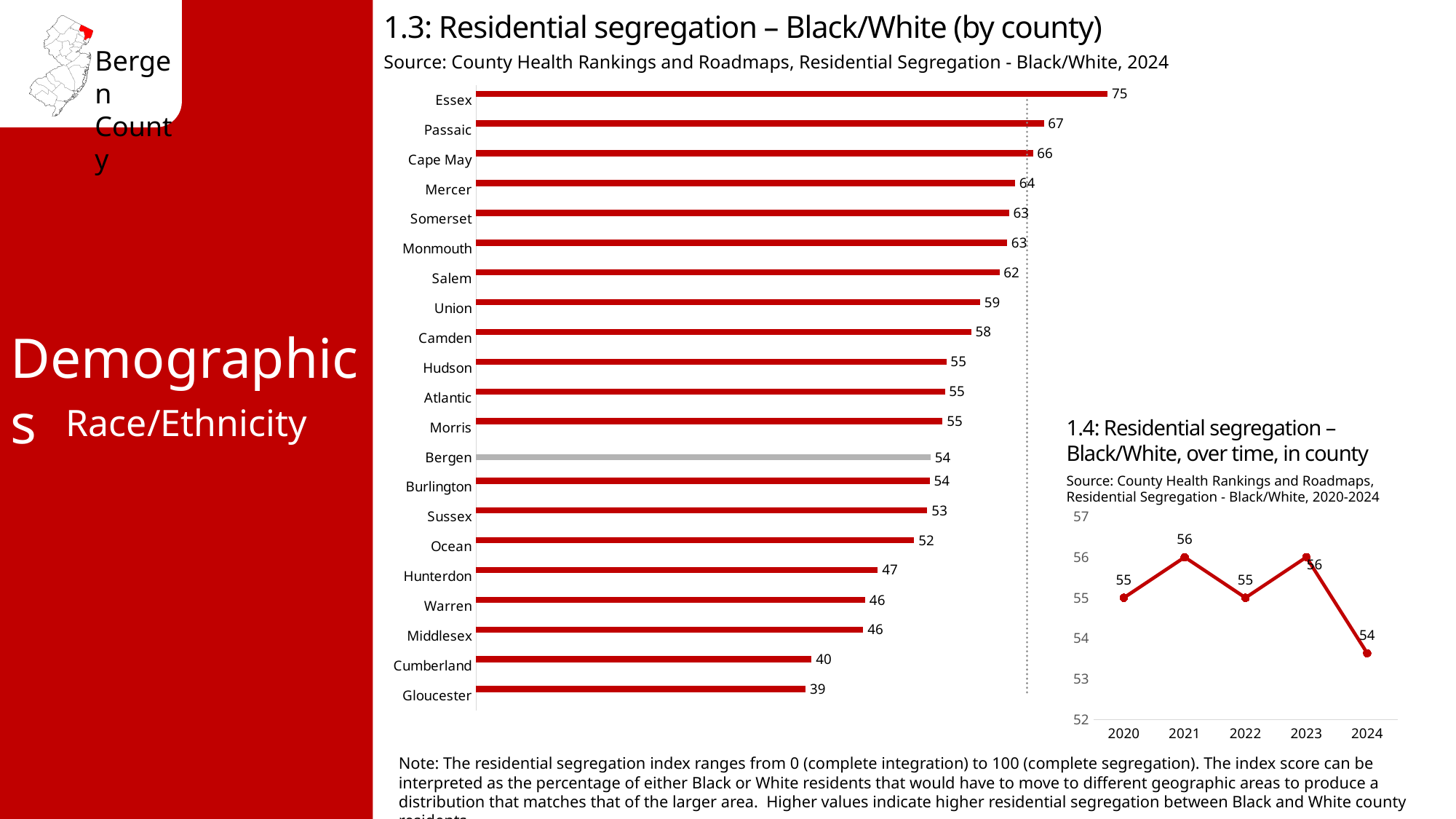
In chart 1.3 (Residential segregation – Black/White by county), what is the value for Bergen? 54 In chart 1.3 (by county), what is the value for Essex? 75 In chart 1.3 (by county), which county has the highest value? Essex In chart 1.4 (over time), what is the difference between the values for 2023 and 2024? 2 In chart 1.3 (by county), how many counties are shown? 21 In chart 1.4 (Residential segregation over time), what is the value for 2024? 54 In chart 1.3 (by county), which has a larger value, Passaic or Hunterdon? Passaic In chart 1.3 (by county), what is the difference between the values for Essex and Gloucester? 36 In chart 1.3 (by county), which bar is coloured grey instead of red? Bergen What kind of chart is chart 1.3 (Residential segregation – Black/White by county)? Bar chart In chart 1.3 (by county), which county has the lowest value? Gloucester In chart 1.4 (over time), how many years are plotted? 5